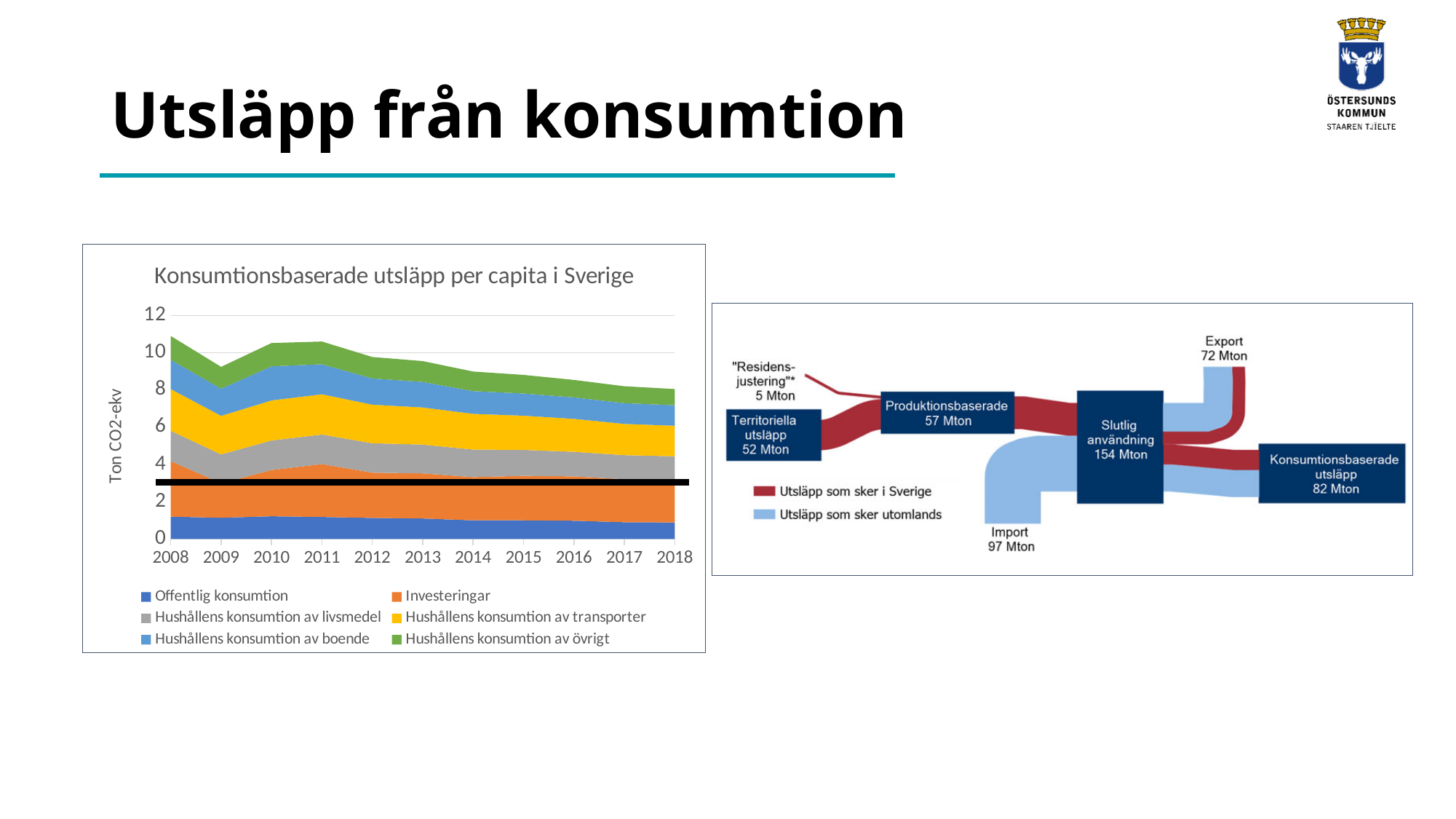
In the left chart 'Konsumtionsbaserade utsläpp per capita i Sverige', how many years are shown on the x axis? 11 What type of chart is the left chart titled 'Konsumtionsbaserade utsläpp per capita i Sverige'? Stacked area chart In the right flow diagram, which is larger, Import or Export? Import In the left chart 'Konsumtionsbaserade utsläpp per capita i Sverige', is the total stacked value for 2018 greater or less than 10? less What is the y-axis label of the left chart 'Konsumtionsbaserade utsläpp per capita i Sverige'? Ton CO2-ekv In the left chart 'Konsumtionsbaserade utsläpp per capita i Sverige', is the total stacked value for 2008 greater or less than 10? greater In the right flow diagram, what is the value shown for 'Slutlig användning'? 154 Mton In the right flow diagram, what is the value shown for 'Konsumtionsbaserade utsläpp'? 82 Mton In the left chart 'Konsumtionsbaserade utsläpp per capita i Sverige', does the total stacked value rise or fall from 2008 to 2018? Fall In the right flow diagram, what is the difference between 'Slutlig användning' (154 Mton) and 'Export' (72 Mton)? 82 Mton In the left chart 'Konsumtionsbaserade utsläpp per capita i Sverige', which year has the lowest total stacked value? 2018 How many series does the legend of the left chart 'Konsumtionsbaserade utsläpp per capita i Sverige' list? 6